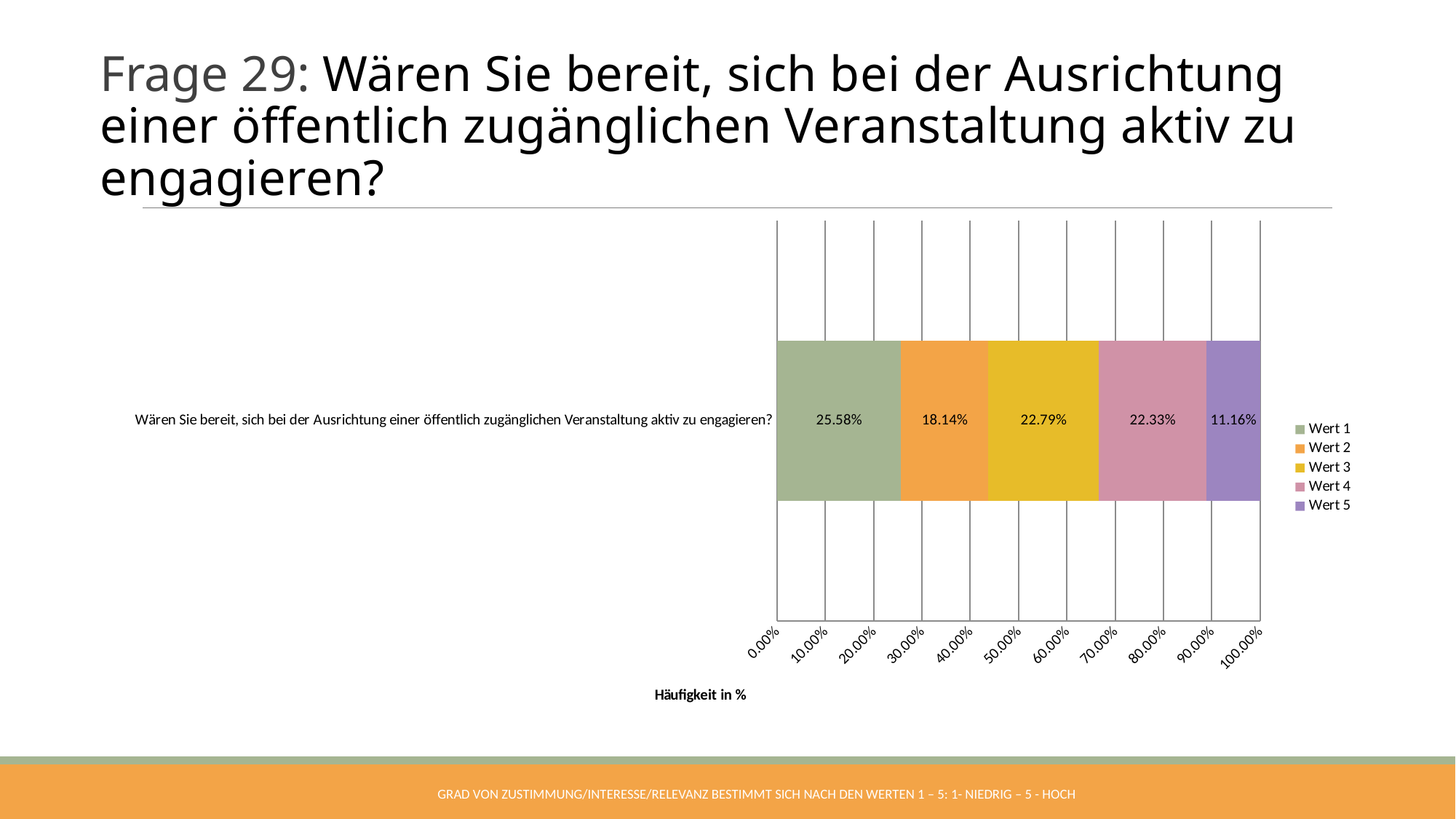
What is the difference between the values for Wert 1 and Wert 5? 14.42% What is the value for Wert 1? 25.58% What is the label of the horizontal axis? Häufigkeit in % How many series does the legend list? 5 What kind of chart is shown on the slide? Stacked bar chart What is the value for Wert 5? 11.16% What is the value for Wert 3? 22.79% What is the value for Wert 4? 22.33% Which series has the lowest value? Wert 5 Which is larger, the value for Wert 2 or the value for Wert 3? Wert 3 Which series has the highest value? Wert 1 What is the value for Wert 2? 18.14%